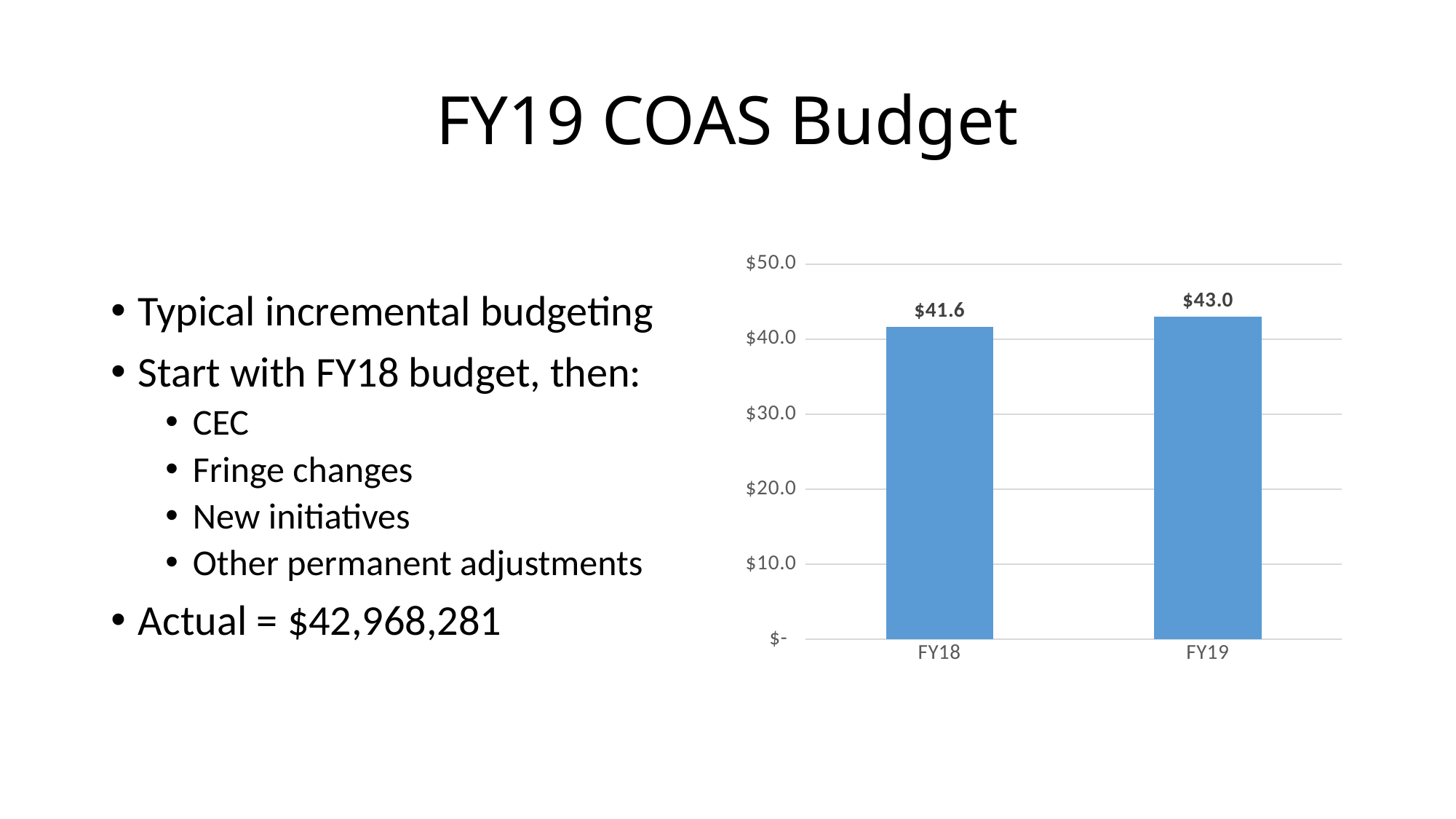
Which category has the lowest value? FY18 Which is larger, the value for FY18 or the value for FY19? FY19 What kind of chart is shown on the slide? bar chart Is the value for FY18 greater or less than $40.0? greater Which category has the highest value? FY19 Do the values rise or fall from FY18 to FY19? rise What is the value shown for FY19? $43.0 What is the value shown for FY18? $41.6 How many categories are shown on the x axis? 2 What is the highest tick label on the y axis? $50.0 Is the value for FY19 greater or less than $50.0? less What is the difference between the FY19 and FY18 values? $1.4